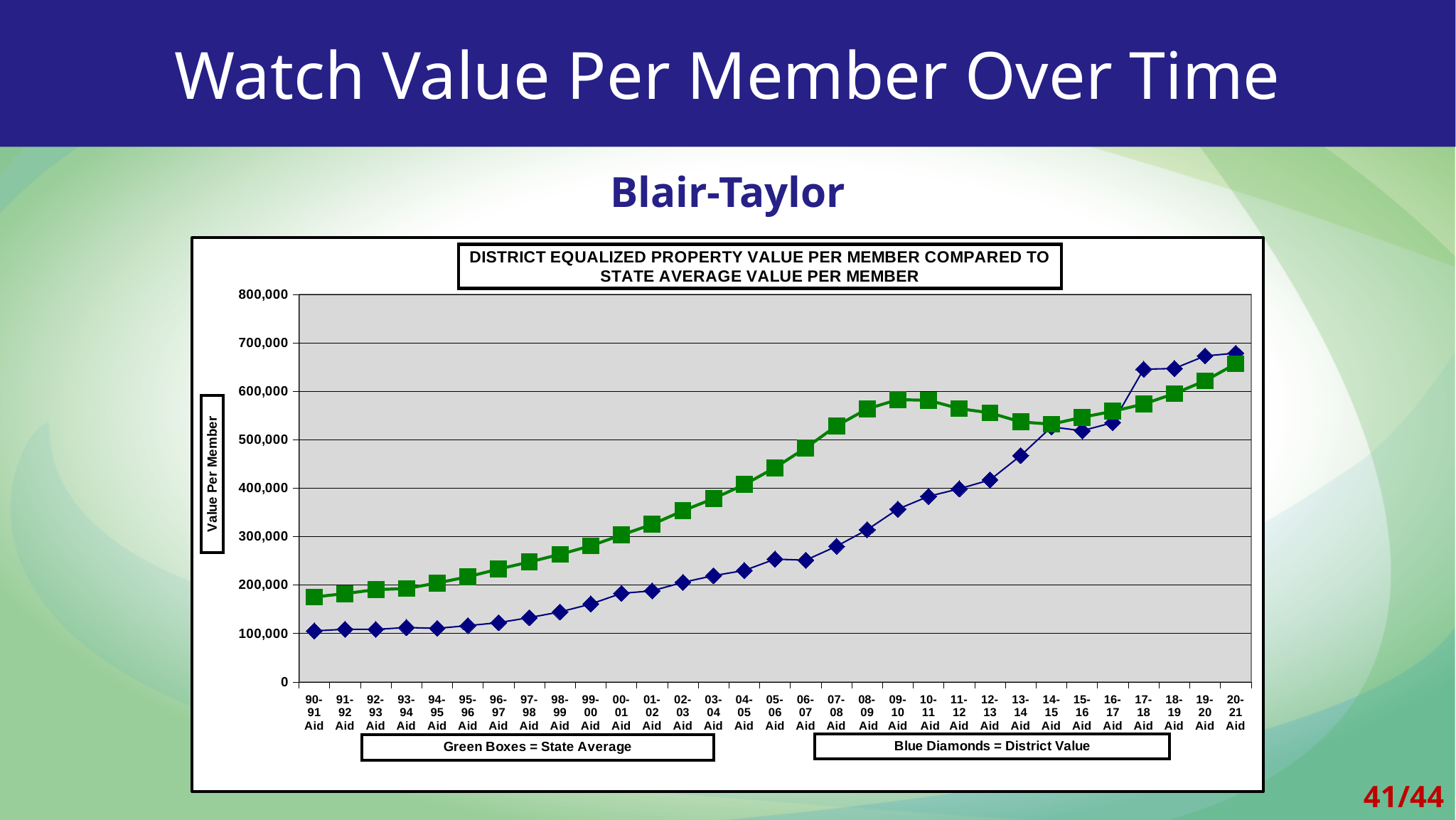
What kind of chart is shown on the slide? line chart In 09-10 Aid, which is larger: the State Average or the District Value? State Average In which year is the District Value (blue diamonds) lowest? 90-91 Aid Is the District Value for 17-18 Aid greater or less than 600,000? greater Does the District Value generally rise or fall from 90-91 Aid to 20-21 Aid? rise In which year is the District Value (blue diamonds) highest? 20-21 Aid What is the label on the vertical axis of the chart? Value Per Member In which year is the State Average (green boxes) highest? 20-21 Aid What do the green boxes represent on the chart? State Average How many series are plotted on the chart? 2 Is the District Value for 13-14 Aid greater or less than 500,000? less How many school years (x-axis categories) are plotted on the chart? 31